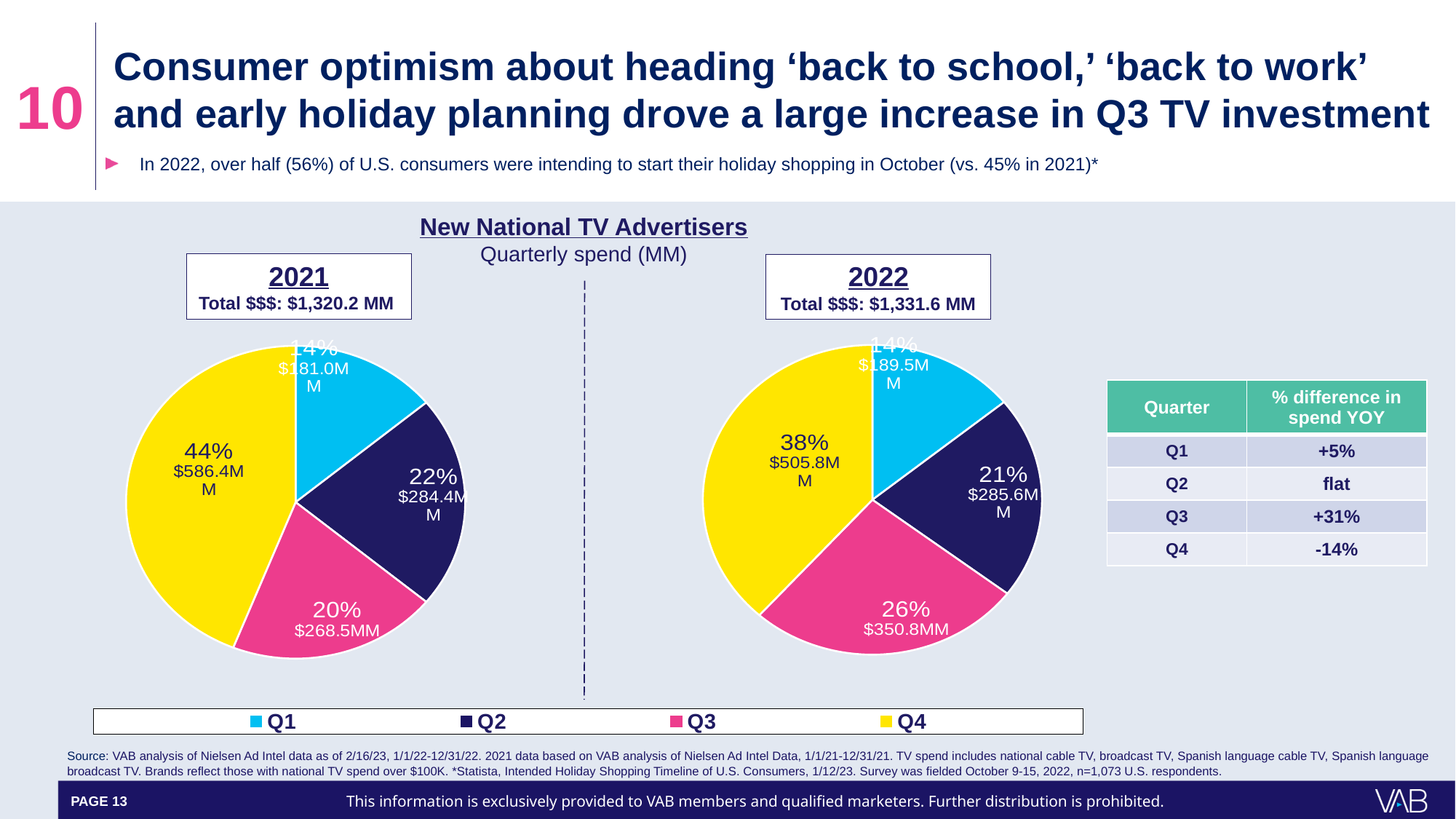
In the 2022 pie chart, what is the spend value for Q1? $189.5MM In the 2021 pie chart, what is the spend value for Q3? $268.5MM How many slices does each pie chart have? 4 In the 2022 pie chart, which quarter has the largest share of spend? Q4 How many entries does the legend list? 4 What is the difference between the Q4 spend in the 2021 pie chart and the Q4 spend in the 2022 pie chart? $80.6MM In the 2022 pie chart, is the spend for Q3 larger or smaller than the spend for Q2? Larger In the 2022 pie chart, what share of spend does Q3 account for? 26% In the 2021 pie chart, which quarter has the smallest share of spend? Q1 What colour represents Q4 in the pie charts? Yellow What kind of charts are shown on the slide? Pie charts In the 2021 pie chart, what share of spend does Q4 account for? 44%